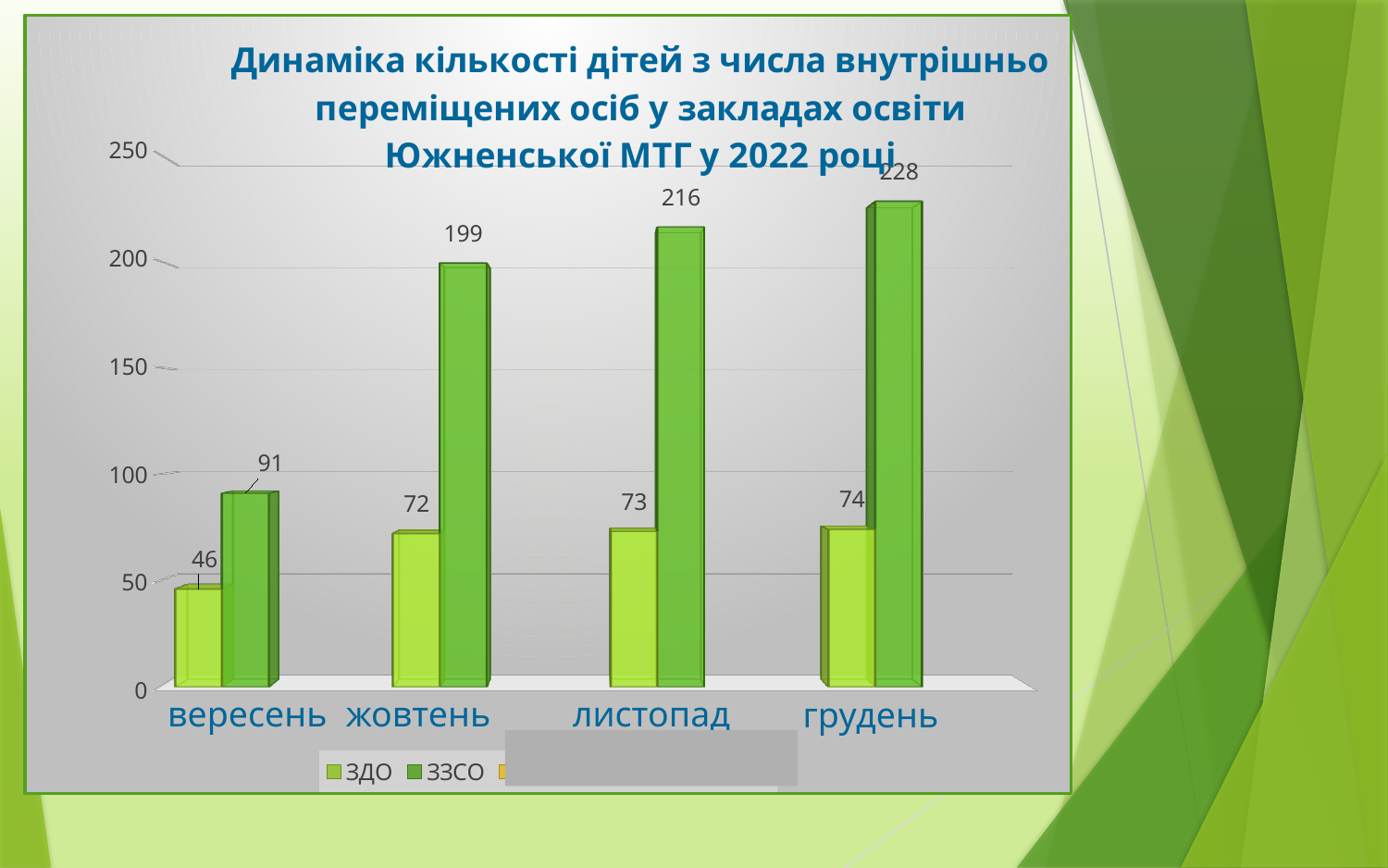
Do the ЗЗСО values rise or fall from вересень to грудень? rise What is the value for ЗДО in вересень? 46 What is the value for ЗЗСО in грудень? 228 Is the ЗЗСО value for листопад greater or less than 200? greater What is the value for ЗЗСО in жовтень? 199 In which month is the ЗДО value lowest? вересень How many months are shown on the x axis? 4 Which is larger: the ЗЗСО value in вересень or the ЗДО value in грудень? ЗЗСО in вересень What kind of chart is shown on the slide? bar chart What is the difference between the ЗЗСО and ЗДО values in листопад? 143 In which month is the ЗЗСО value highest? грудень What is the value for ЗДО in листопад? 73